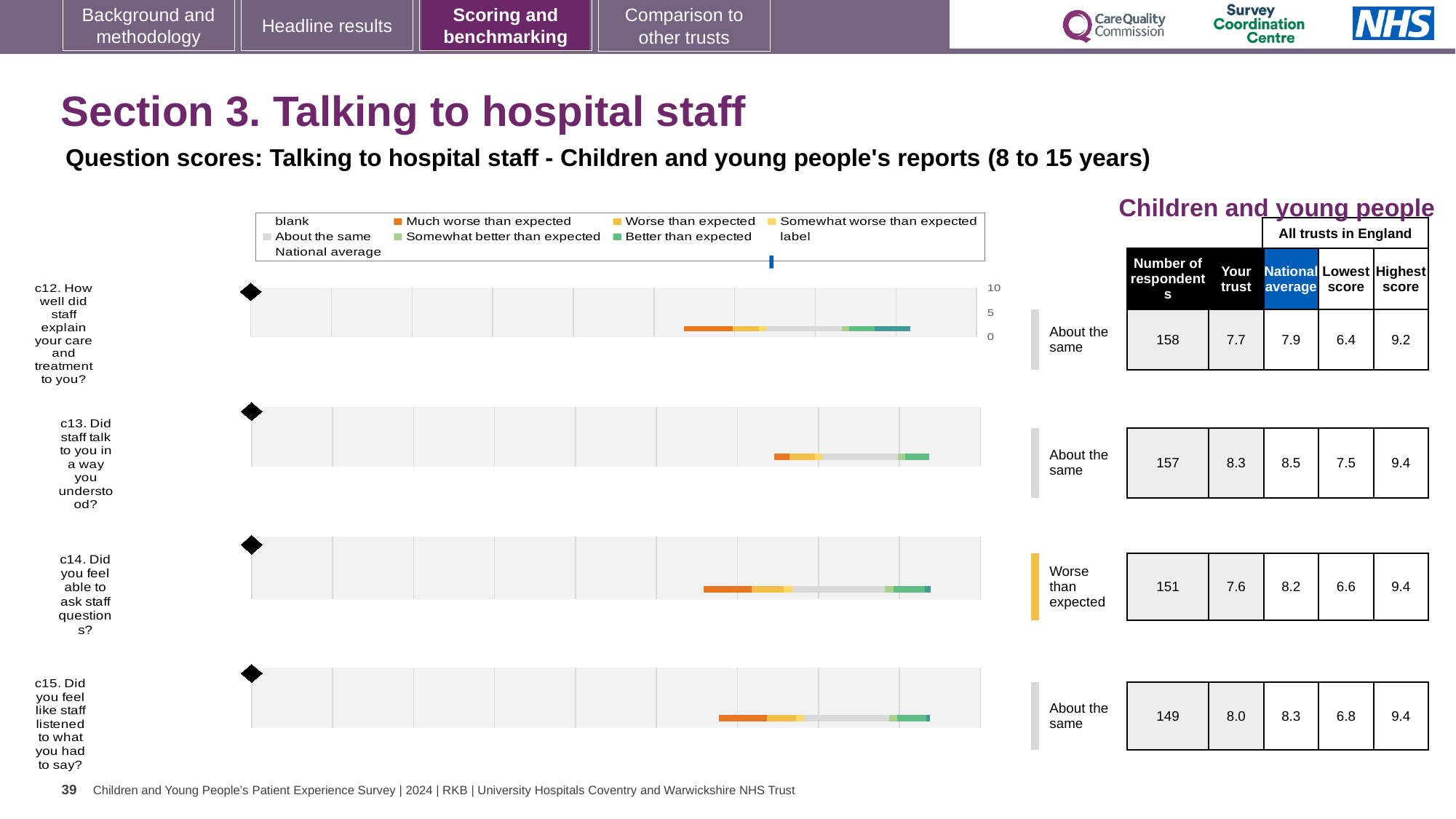
What is the lowest score across all trusts in England for c12? 6.4 What kind of chart is used to show the question scores for c12 to c15? Bar chart How many questions (c12 to c15) are plotted on the slide? 4 Which question is rated 'Worse than expected' for this trust? c14. Did you feel able to ask staff questions? Which question has the lowest 'Your trust' score? c14. Did you feel able to ask staff questions? What is the national average score for c13 (Did staff talk to you in a way you understood?)? 8.5 What is the 'Your trust' score for c12 (How well did staff explain your care and treatment to you?)? 7.7 Which question has the highest 'Your trust' score? c13. Did staff talk to you in a way you understood? Is the 'Your trust' score for c12 larger or smaller than the national average for c12? Smaller What is the number of respondents for c14 (Did you feel able to ask staff questions?)? 151 What is the highest score across all trusts in England for c15 (Did you feel like staff listened to what you had to say?)? 9.4 What is the difference between the national average and the 'Your trust' score for c14? 0.6